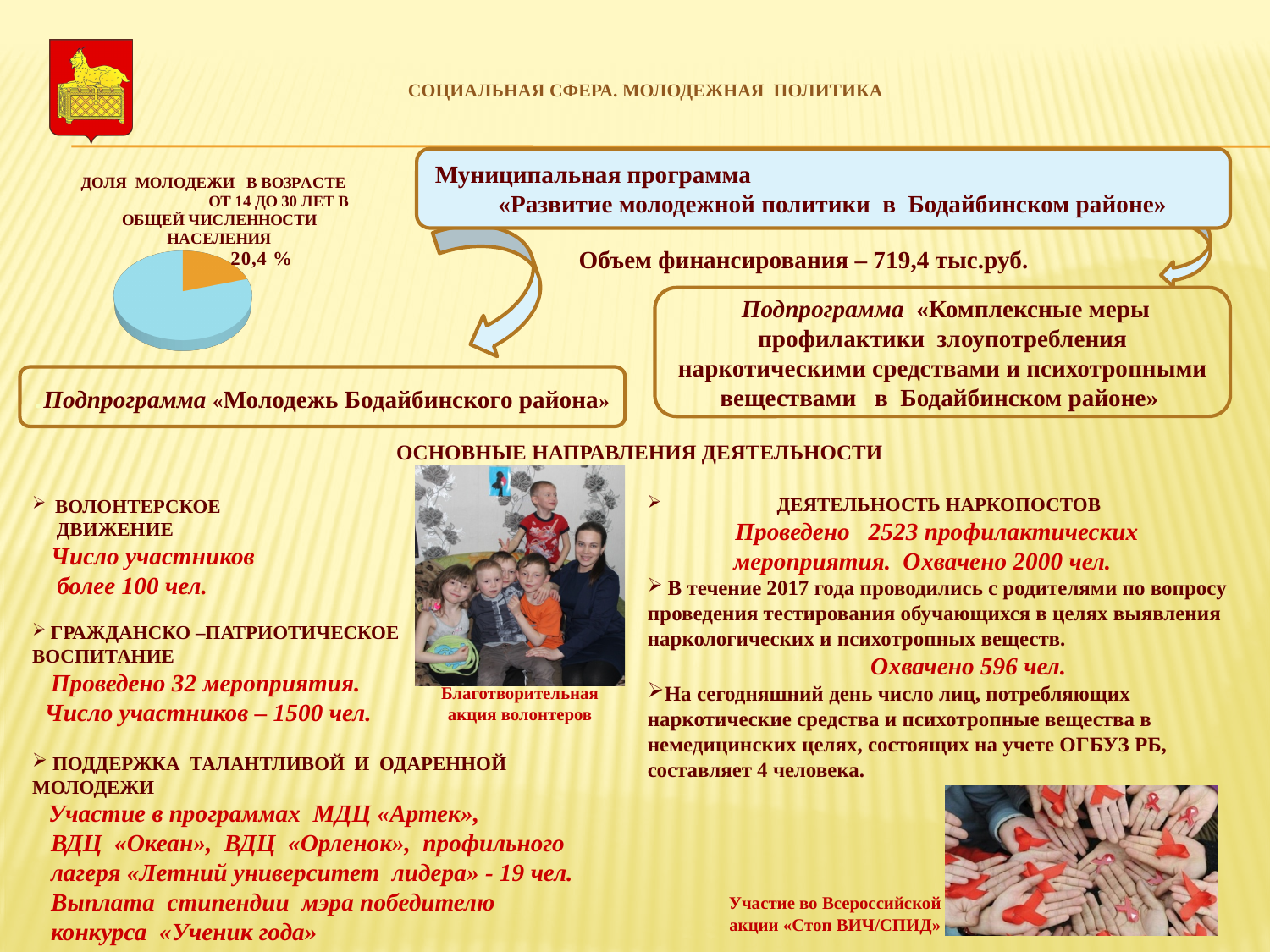
Which slice of the pie chart is larger, the orange slice or the blue slice? the blue slice What is the title of the pie chart? Доля молодежи в возрасте от 14 до 30 лет в общей численности населения What kind of chart is shown on the slide? pie chart What colour is the slice labelled 20,4 % in the pie chart? orange What is the share of the orange slice in the pie chart? 20,4 % What share of the total population is made up of young people aged 14 to 30, according to the pie chart? 20,4 % How many slices does the pie chart have? 2